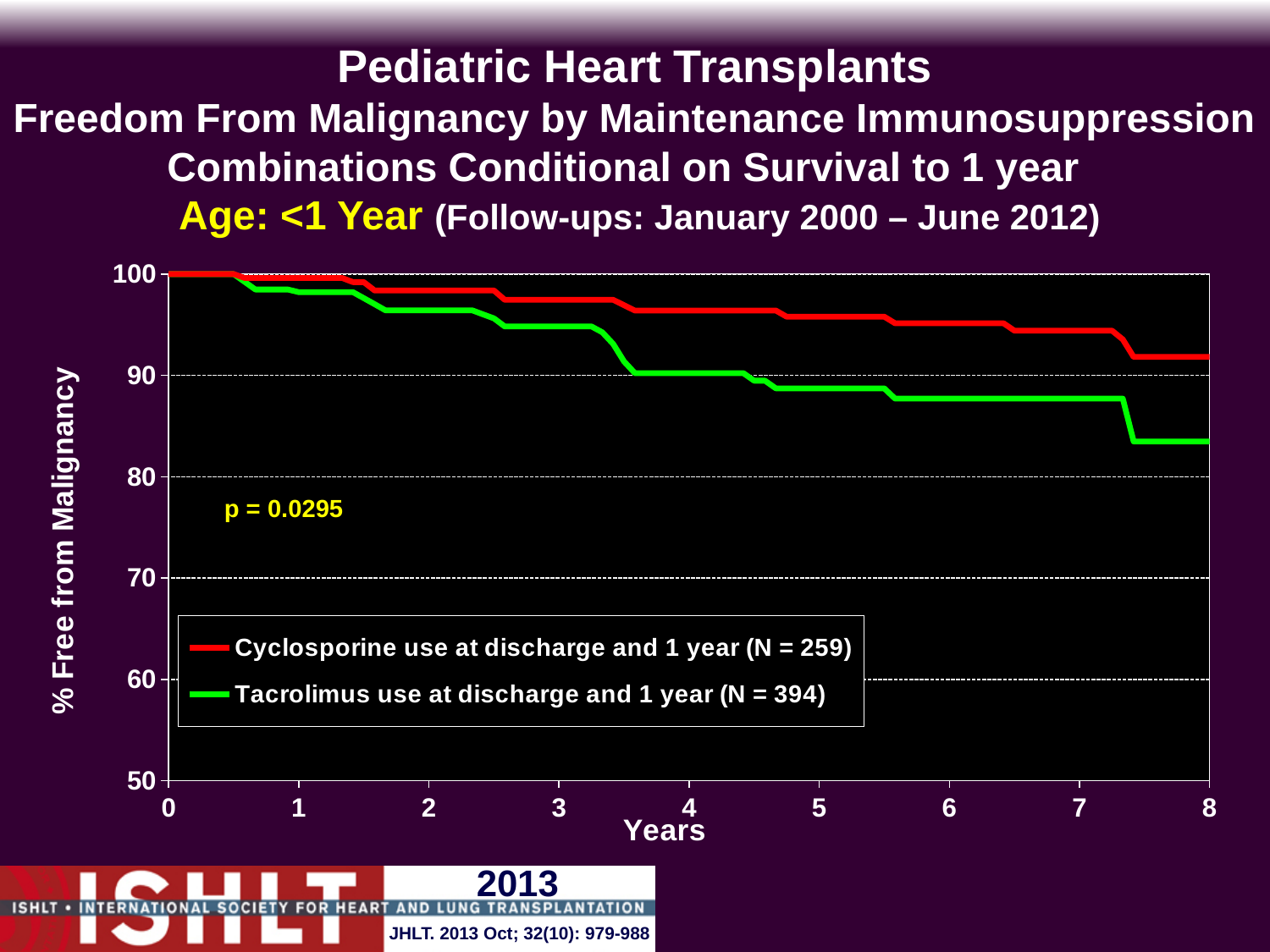
Is the value for Tacrolimus use at 8 years greater or less than 90? less Is the value for Tacrolimus use at 2 years greater or less than 90? greater Is the value for Tacrolimus use at 6 years greater or less than 90? less Do the values for the Cyclosporine series rise or fall as years increase? fall How many series does the legend list? 2 What kind of chart is shown on the slide? line chart Which series is drawn in green? Tacrolimus use at discharge and 1 year (N = 394) Do the values for the Tacrolimus series rise or fall as years increase? fall What is the N for the Cyclosporine use at discharge and 1 year series? 259 At 8 years, which series has the higher % free from malignancy, Cyclosporine or Tacrolimus? Cyclosporine